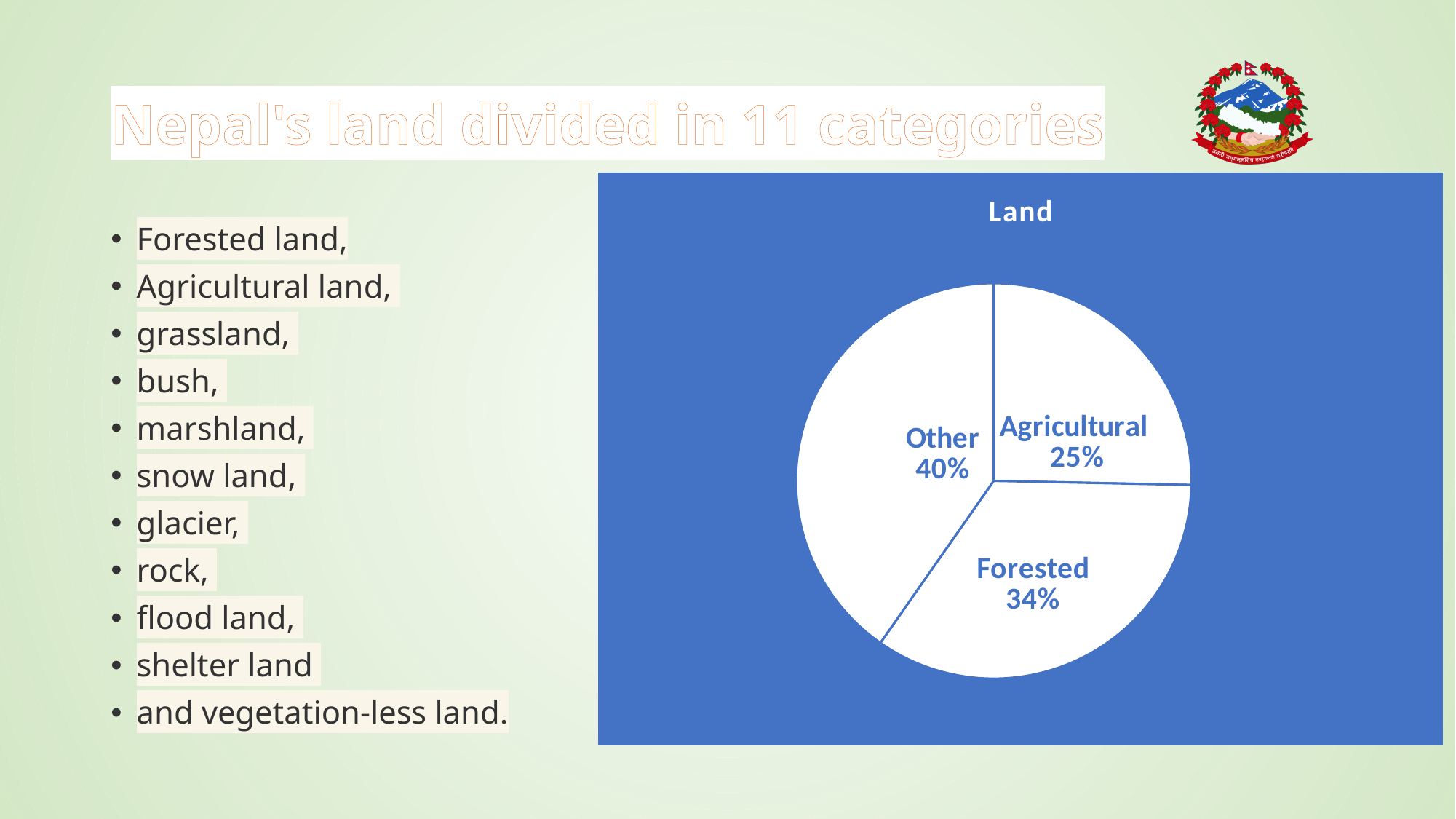
What is the difference in percentage points between the Other and Forested slices? 6 What share of the pie is Agricultural land? 25% Which slice of the pie is the largest? Other Which slice of the pie is the smallest? Agricultural What is the difference in percentage points between the Forested and Agricultural slices? 9 Which is larger, the Agricultural slice or the Forested slice? Forested What is the title of the chart? Land What kind of chart is shown on the slide? pie chart What share of the pie is Forested land? 34% Which is larger, the Forested slice or the Other slice? Other How many slices does the pie chart have? 3 What share of the pie is Other? 40%